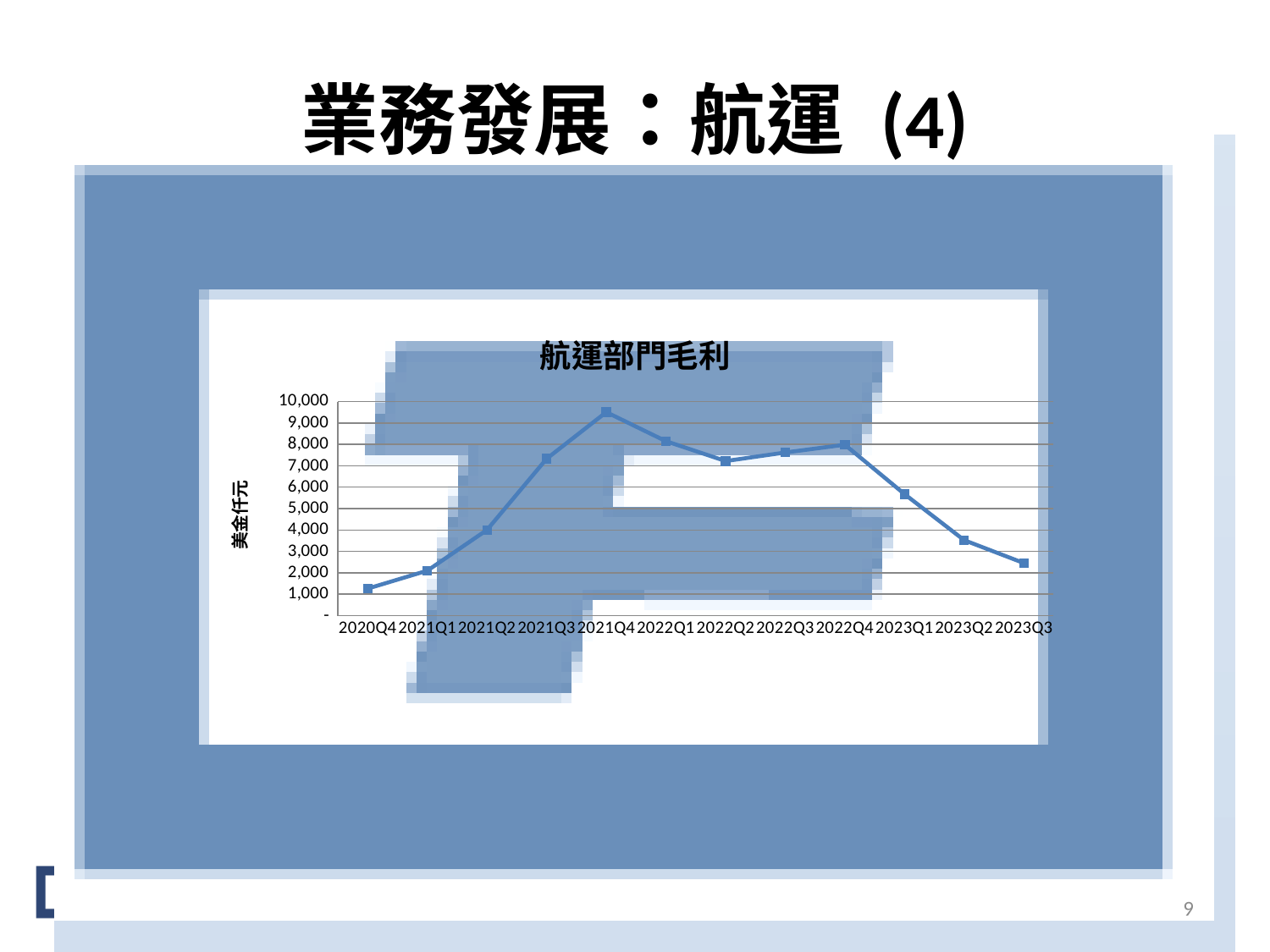
Is the value for 2020Q4 greater or less than 2,000? less What is the title of the chart? 航運部門毛利 Which quarter has the lowest value? 2020Q4 What is the label on the vertical axis of the chart? 美金仟元 Is the value for 2023Q1 greater or less than 5,000? greater Which quarter has the highest value? 2021Q4 Do the values rise or fall from 2022Q4 to 2023Q3? fall Is the value for 2021Q4 greater or less than 9,000? greater Which is larger, the value for 2021Q3 or the value for 2023Q2? 2021Q3 How many quarters are plotted along the x axis? 12 What kind of chart is shown on the slide? line chart